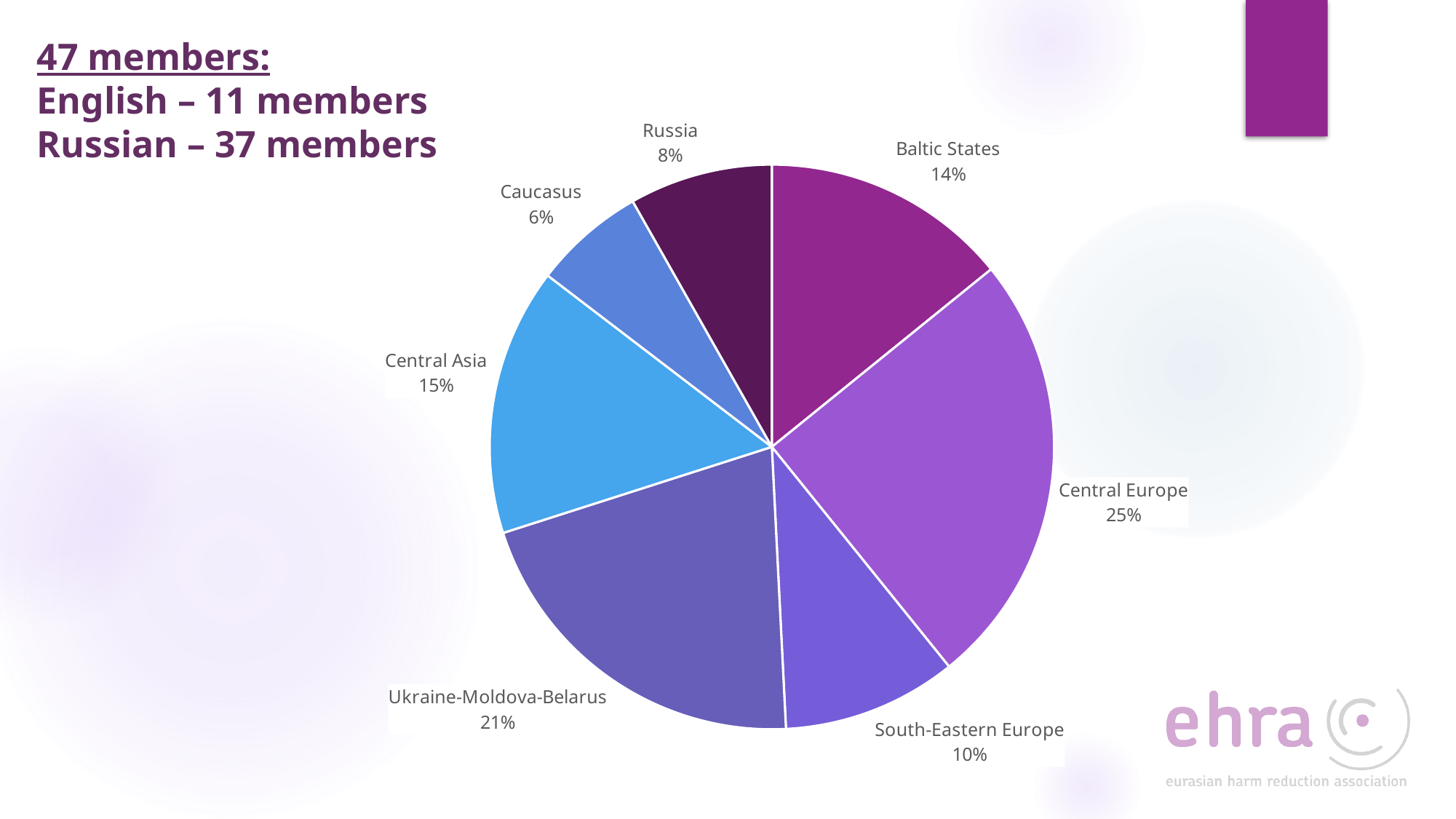
What is the value shown for Caucasus? 6% According to the text on the slide, how many members are Russian-speaking? 37 members Which region has the smallest slice of the pie? Caucasus What share of the pie does Central Europe represent? 25% What share of the pie does Ukraine-Moldova-Belarus represent? 21% What is the difference in percentage points between Central Europe and South-Eastern Europe? 15 Which region has the largest slice of the pie? Central Europe What kind of chart is shown on the slide? Pie chart What is the difference in percentage points between Central Asia and Russia? 7 Which is larger, the slice for Baltic States or the slice for South-Eastern Europe? Baltic States What is the value shown for Baltic States? 14% How many regions are shown in the pie chart? 7